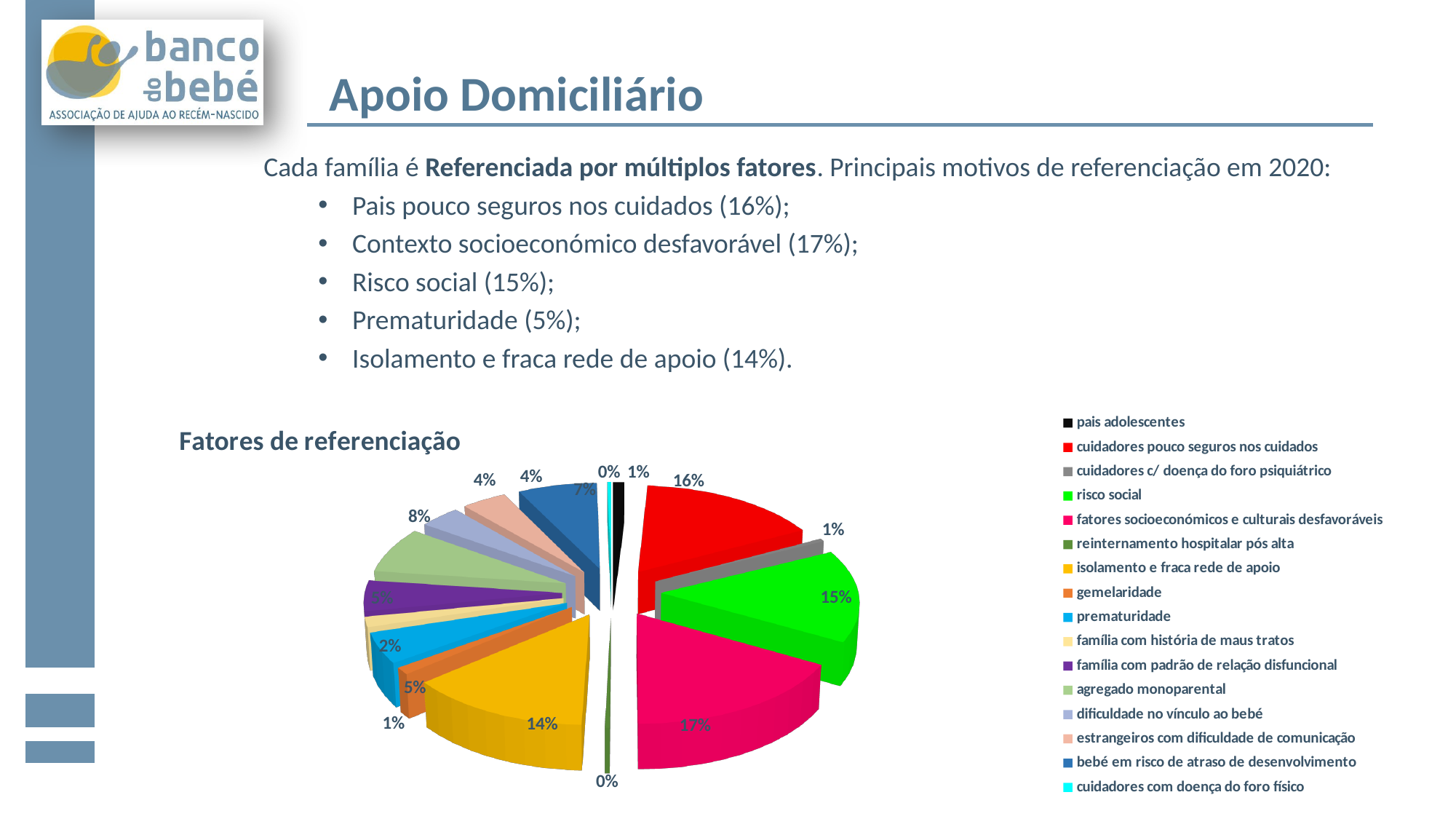
What share of the pie does 'agregado monoparental' represent? 8% What is the title of the chart on the slide? Fatores de referenciação What is the difference between the share for 'cuidadores pouco seguros nos cuidados' and the share for 'prematuridade'? 11% What share of the pie does 'isolamento e fraca rede de apoio' represent? 14% How many categories does the legend of the pie chart list? 16 Which category has the largest slice of the pie? fatores socioeconómicos e culturais desfavoráveis What share of the pie does 'bebé em risco de atraso de desenvolvimento' represent? 7% Which is larger, the slice for 'risco social' or the slice for 'agregado monoparental'? risco social What type of chart is shown on the slide? pie chart